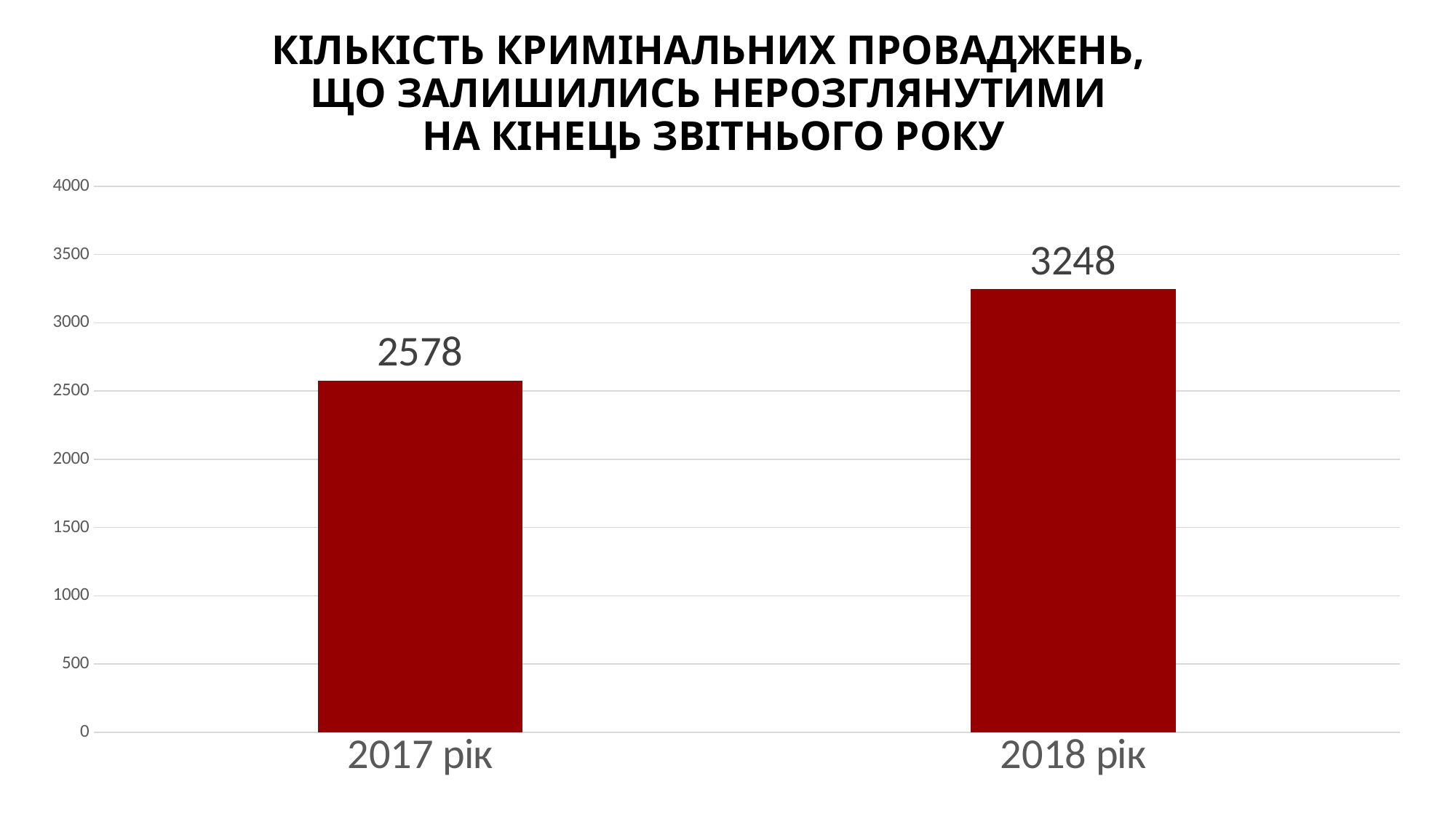
Which is larger, the value for 2017 рік or the value for 2018 рік? 2018 рік Which year has the highest value? 2018 рік Is the value for 2017 рік greater or less than 3000? less How many categories are shown on the x axis? 2 Do the values rise or fall from 2017 рік to 2018 рік? rise What is the difference between the values for 2018 рік and 2017 рік? 670 What is the value for 2018 рік? 3248 What is the value for 2017 рік? 2578 Is the value for 2018 рік greater or less than 3000? greater What colour are the bars in the chart? dark red What kind of chart is shown on the slide? bar chart Which year has the lowest value? 2017 рік